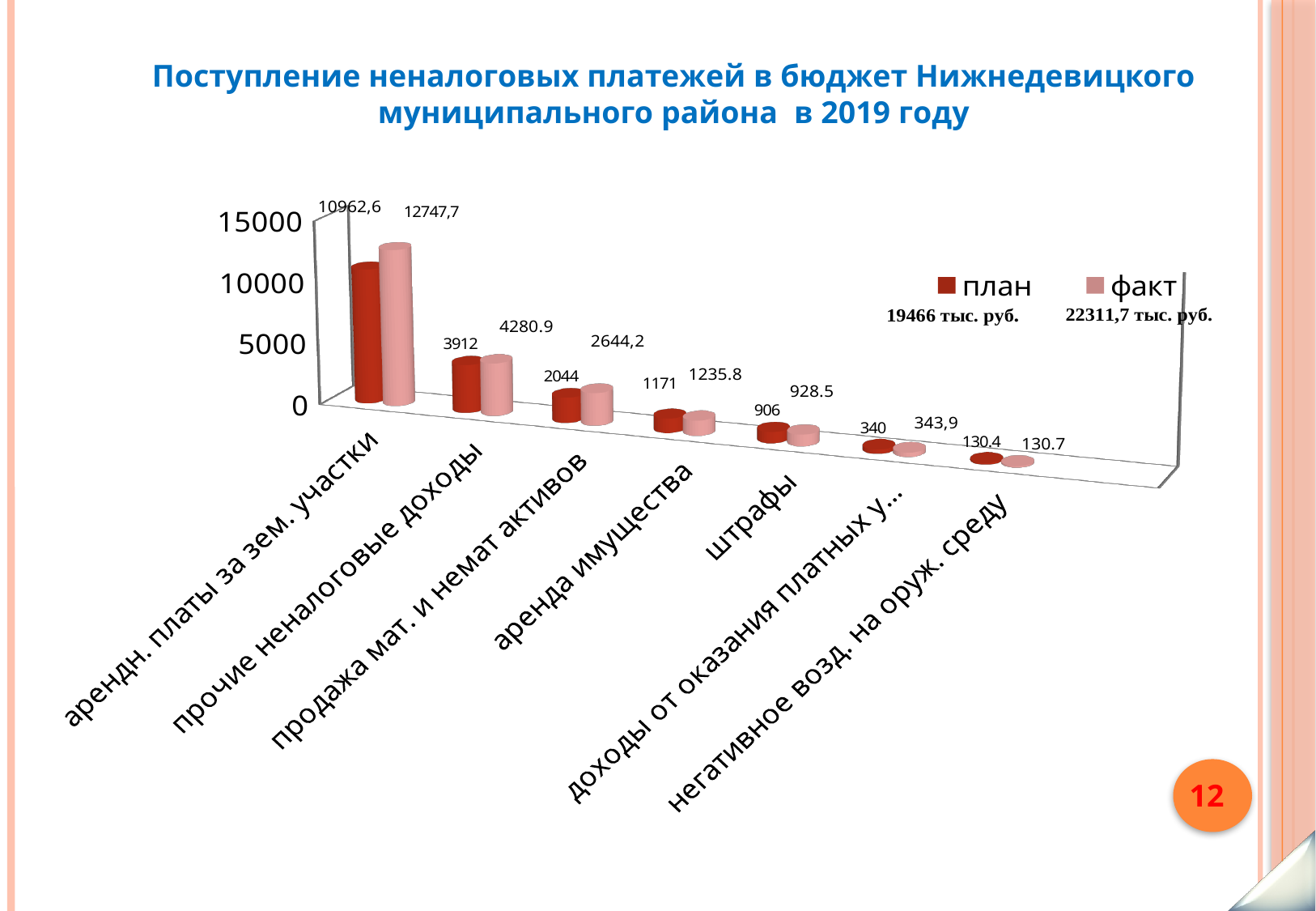
What is the план value for штрафы? 906 Which category has the highest факт value? арендн. платы за зем. участки What is the difference between the факт and план values for прочие неналоговые доходы? 368.9 How many categories are shown on the x axis? 7 What is the факт value for продажа мат. и немат активов? 2644,2 Which category has the lowest план value? негативное возд. на оруж. среду What is the план value for прочие неналоговые доходы? 3912 How many series does the legend list? 2 What is the факт value for арендн. платы за зем. участки? 12747,7 Do the план values rise or fall moving from left to right along the x axis? fall What kind of chart is shown on the slide? bar chart Which is larger for аренда имущества: the план value or the факт value? факт